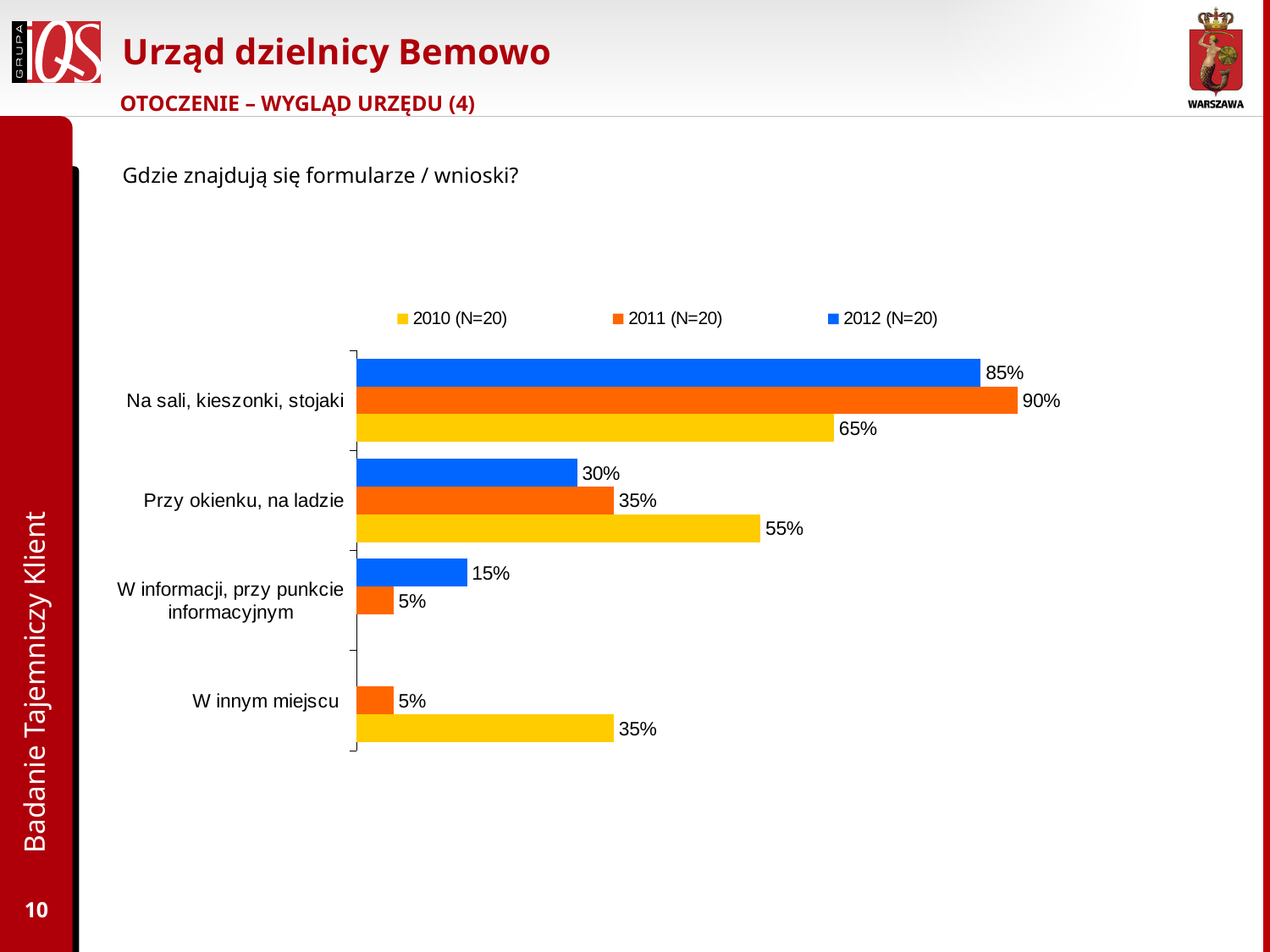
Which category has the lowest value in the 2011 (N=20) series? W informacji, przy punkcie informacyjnym and W innym miejscu (both 5%) How many series does the legend list? 3 What is the value for 'Na sali, kieszonki, stojaki' in the 2011 (N=20) series? 90% Which series is shown in blue in the legend? 2012 (N=20) Which category has the highest value in the 2012 (N=20) series? Na sali, kieszonki, stojaki What is the value for 'W informacji, przy punkcie informacyjnym' in the 2012 (N=20) series? 15% What is the value for 'Przy okienku, na ladzie' in the 2010 (N=20) series? 55% For 'Przy okienku, na ladzie', which is larger: the 2010 (N=20) value or the 2012 (N=20) value? 2010 (N=20) What type of chart is shown on the slide? bar chart What is the value for 'W innym miejscu' in the 2010 (N=20) series? 35% How many categories are shown on the chart? 4 What is the difference between the 2011 (N=20) and 2010 (N=20) values for 'Na sali, kieszonki, stojaki'? 25%